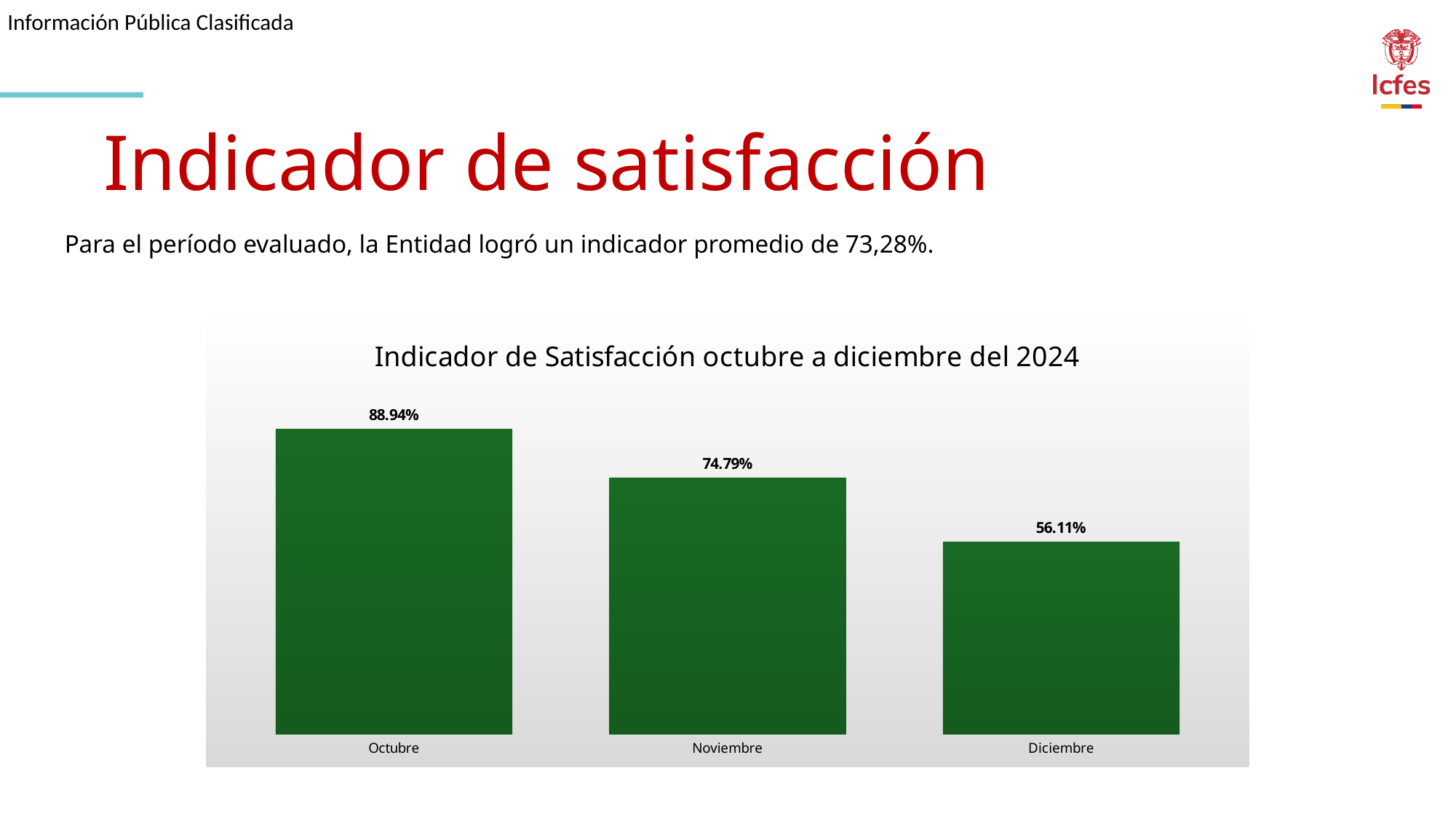
What is the value for Noviembre? 74.79% Which month has the lowest value? Diciembre What is the value for Octubre? 88.94% What is the title of the chart? Indicador de Satisfacción octubre a diciembre del 2024 What is the difference between the values for Octubre and Noviembre? 14.15% Which is larger, the value for Noviembre or the value for Diciembre? Noviembre What kind of chart is shown? Bar chart Which month has the highest value? Octubre What is the value for Diciembre? 56.11% What is the difference between the values for Octubre and Diciembre? 32.83% How many months are shown in the chart? 3 Do the values rise or fall from Octubre to Diciembre? Fall